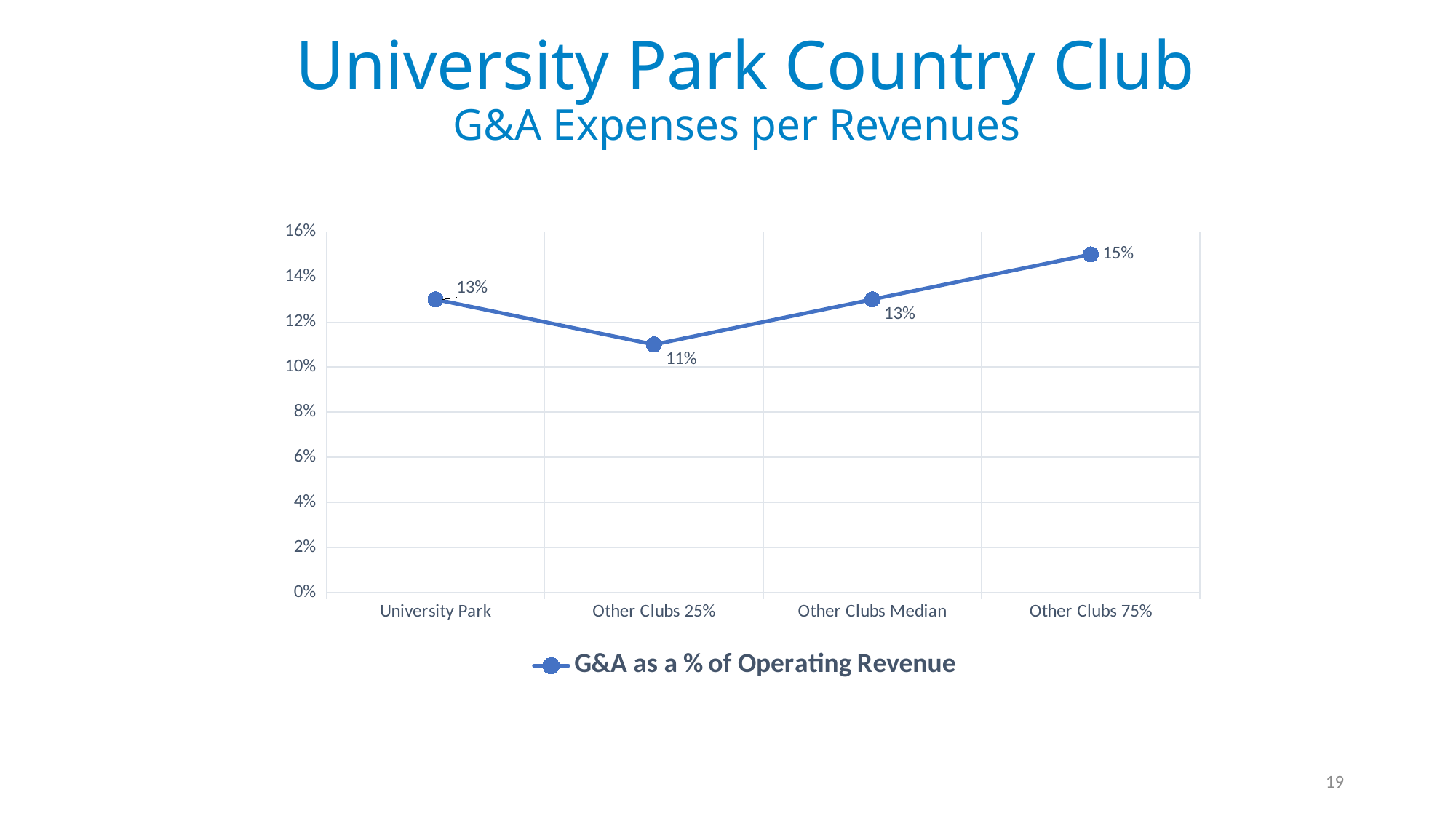
Which is larger, the value for University Park or the value for Other Clubs 25%? University Park What is the legend entry for the plotted series? G&A as a % of Operating Revenue What is the G&A as a % of Operating Revenue for Other Clubs 25%? 11% What is the G&A as a % of Operating Revenue for University Park? 13% Which category has the lowest G&A as a % of Operating Revenue? Other Clubs 25% How many series does the legend list? 1 How many categories are plotted on the x axis? 4 What kind of chart is shown on the slide? Line chart Which category has the highest G&A as a % of Operating Revenue? Other Clubs 75% What is the G&A as a % of Operating Revenue for Other Clubs 75%? 15% What is the difference between the values for Other Clubs 75% and Other Clubs 25%? 4% Is the value for Other Clubs 75% greater or less than 14%? greater